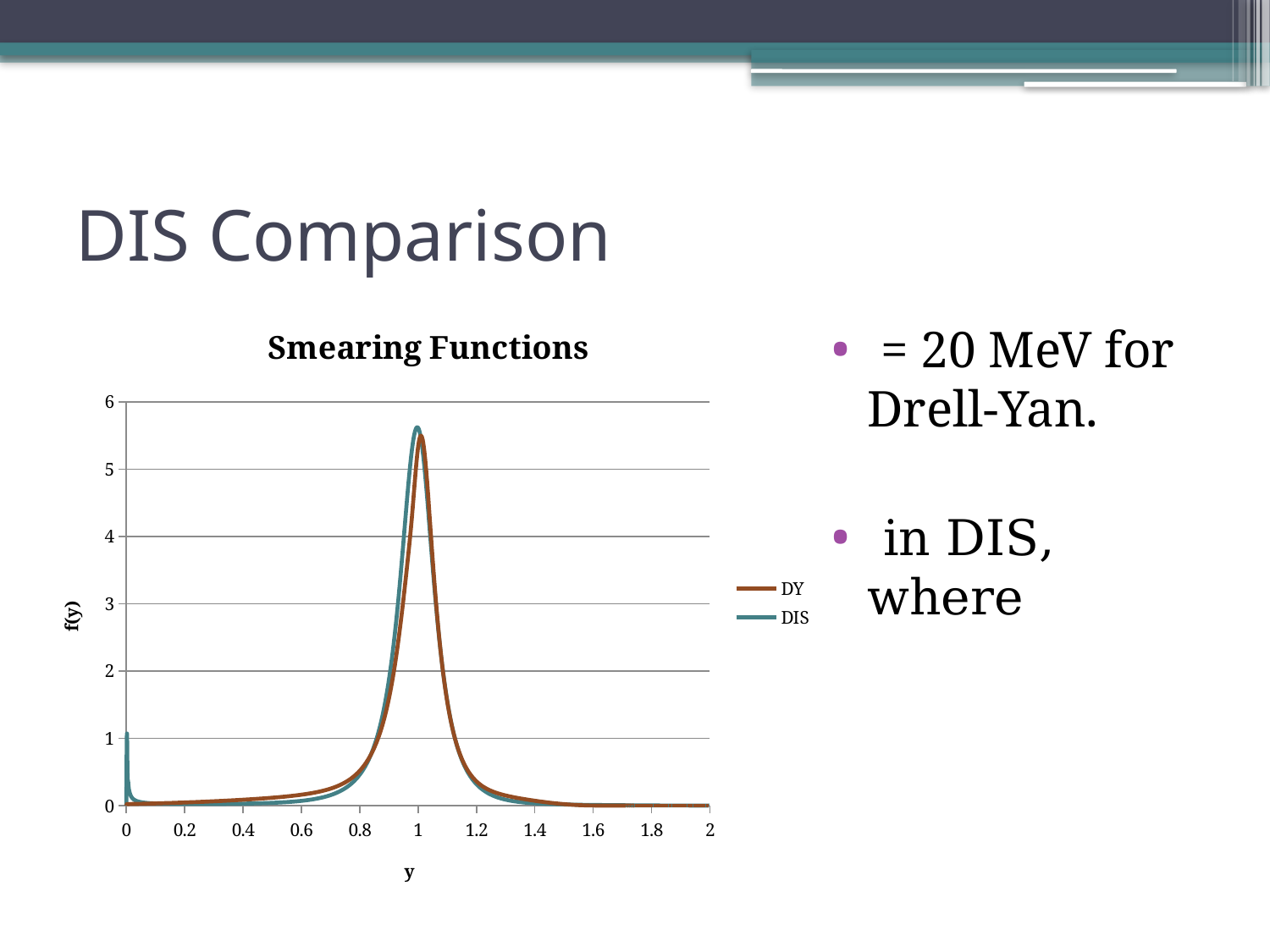
Is the value of the DY curve at y = 0.4 greater or less than 1? less What kind of chart is shown under the title "Smearing Functions"? line chart What is the highest tick value shown on the vertical axis of the "Smearing Functions" chart? 6 Is the peak value of the DY curve greater or less than 5? greater Between y = 0.6 and y = 1, does the DIS curve rise or fall? rise What are the two series named in the legend of the "Smearing Functions" chart? DY and DIS Which x-axis tick is closest to the peak of both curves in the "Smearing Functions" chart? 1 What is the label on the vertical axis of the "Smearing Functions" chart? f(y) Is the value of the DIS curve at y = 1.6 greater or less than 1? less Between y = 1 and y = 2, does the DY curve rise or fall? fall How many series does the legend of the "Smearing Functions" chart list? 2